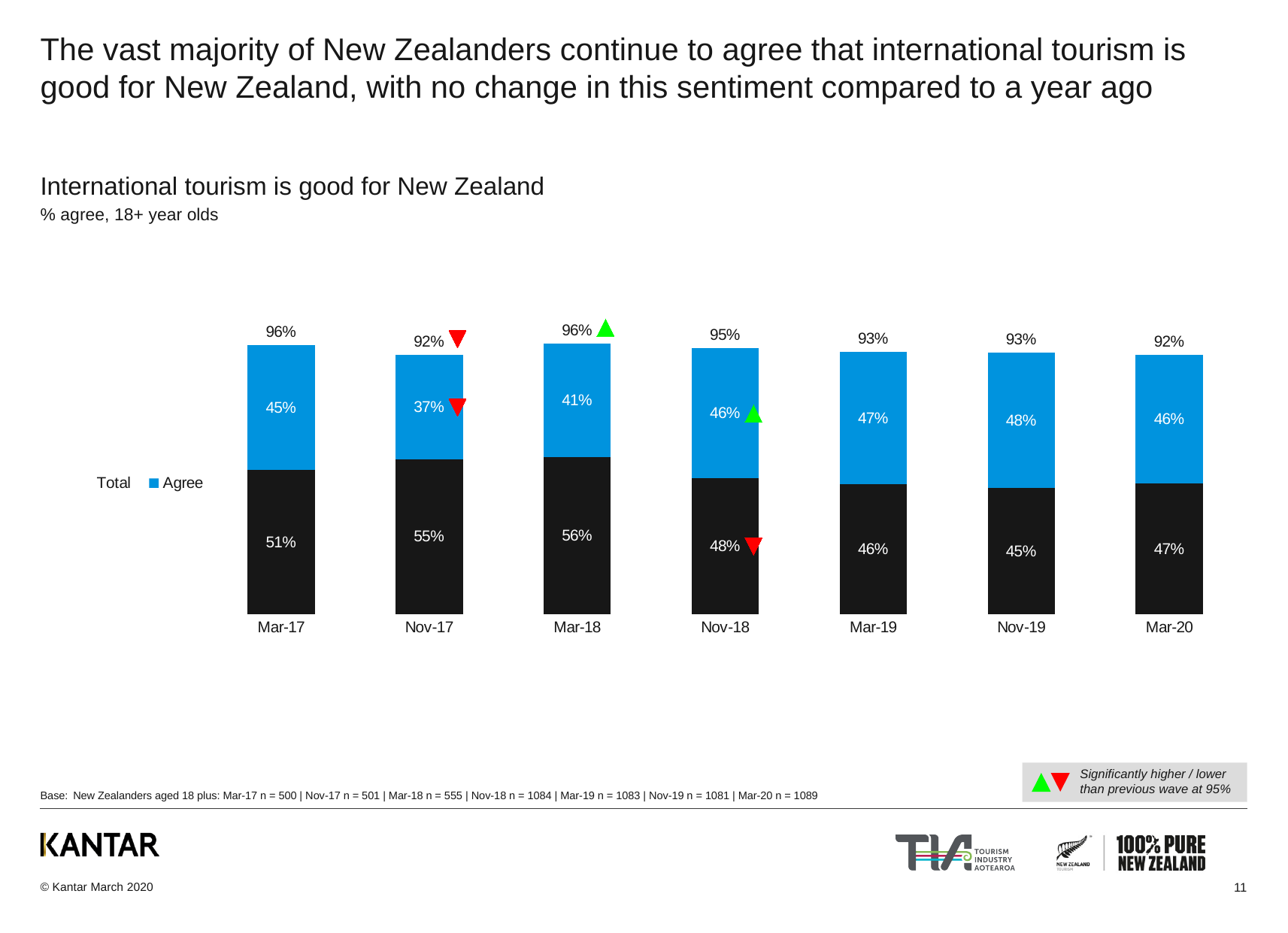
What is the value of the blue (Agree) segment for Nov-17? 37% What is the total value shown above the Mar-20 bar? 92% What is the total value shown above the Mar-17 bar? 96% What kind of chart is shown on the slide? Stacked bar chart What is the difference between the black segment values for Mar-18 and Nov-18? 8% What is the title of the chart? International tourism is good for New Zealand What is the value of the black segment for Mar-18? 56% What is the value of the blue (Agree) segment for Mar-19? 47% Which period has the highest black segment value? Mar-18 Is the blue (Agree) segment larger for Nov-19 or for Mar-20? Nov-19 Which period has the lowest blue (Agree) segment value? Nov-17 How many time periods are shown on the x axis? 7